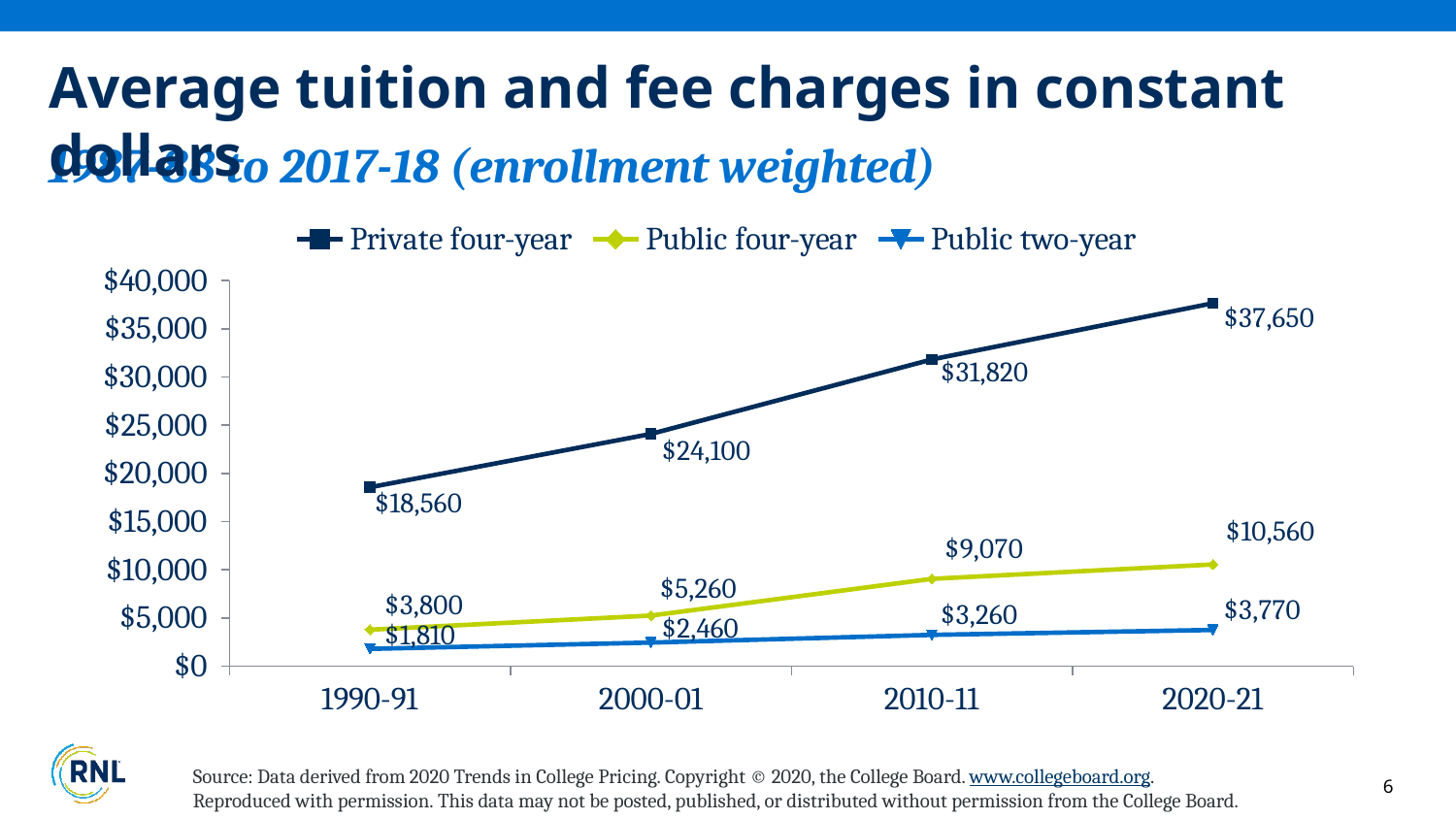
Which is larger: Public four-year in 2000-01 or Public two-year in 2020-21? Public four-year in 2000-01 What is the difference between the Private four-year values in 2020-21 and 1990-91? $19,090 What is the value for Public four-year in 2010-11? $9,070 What is the value for Public two-year in 1990-91? $1,810 Which series has the lowest value in 2010-11? Public two-year What kind of chart is shown on the slide? Line chart What is the value for Private four-year in 2000-01? $24,100 Do the Private four-year values rise or fall from 1990-91 to 2020-21? Rise What is the value for Private four-year in 2020-21? $37,650 How many series does the legend list? 3 Which series has the highest value in 2020-21? Private four-year What is the difference between Public four-year and Public two-year in 2020-21? $6,790